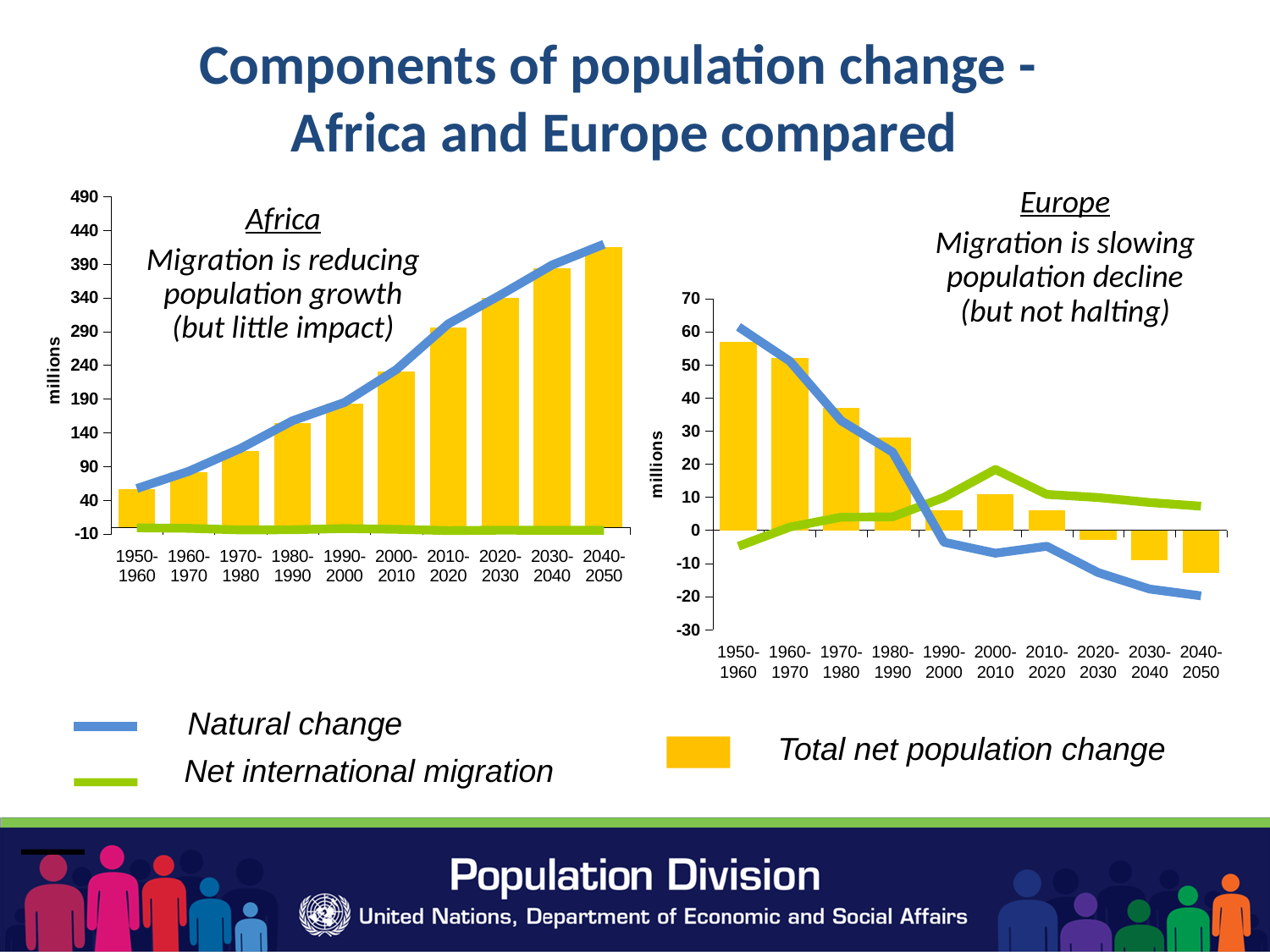
In the Africa chart, which period has the highest total net population change bar? 2040-2050 How many series does the legend list for the charts? 3 In the Europe chart, which period has the highest total net population change bar? 1950-1960 In the Africa chart, is the total net population change for 2040-2050 greater or less than 390? greater In the Europe chart, which period has the lowest total net population change bar? 2040-2050 What kind of chart is the Africa chart on the left? bar and line chart In the Europe chart, is the total net population change for 1950-1960 greater or less than 50? greater In the Africa chart, do the total net population change bars rise or fall from 1950-1960 to 2040-2050? rise In the Europe chart, in which period does the net international migration line reach its peak? 2000-2010 How many time periods are shown on the x axis of the Africa chart? 10 In the Africa chart, which period has the lowest total net population change bar? 1950-1960 What unit is shown on the y axis of both charts? millions